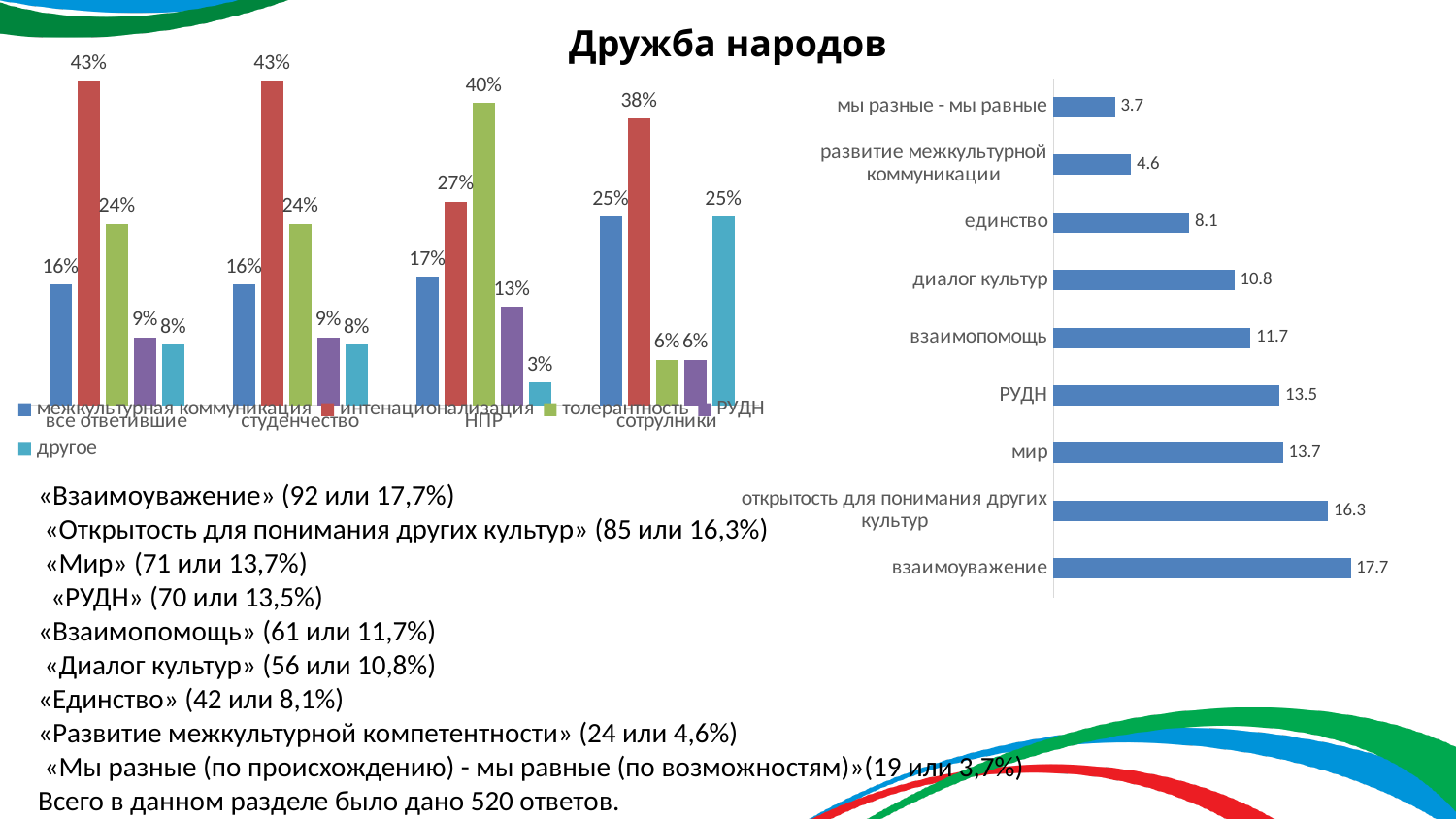
On the right chart, what is the value for взаимоуважение? 17.7 What type of chart is the right chart? bar chart How many series does the legend of the left chart list? 5 On the left chart, what is the value for интенационализация in the сотрудники group? 38% On the right chart, what is the difference between the values for РУДН and единство? 5.4 On the right chart, what is the value for диалог культур? 10.8 On the left chart, what is the value for толерантность in the НПР group? 40% On the left chart, which series has the highest value in the студенчество group? интенационализация How many categories are shown on the right chart? 9 On the right chart, which category has the highest value? взаимоуважение On the left chart, which is larger in the сотрудники group: межкультурная коммуникация or толерантность? межкультурная коммуникация On the right chart, which category has the lowest value? мы разные - мы равные